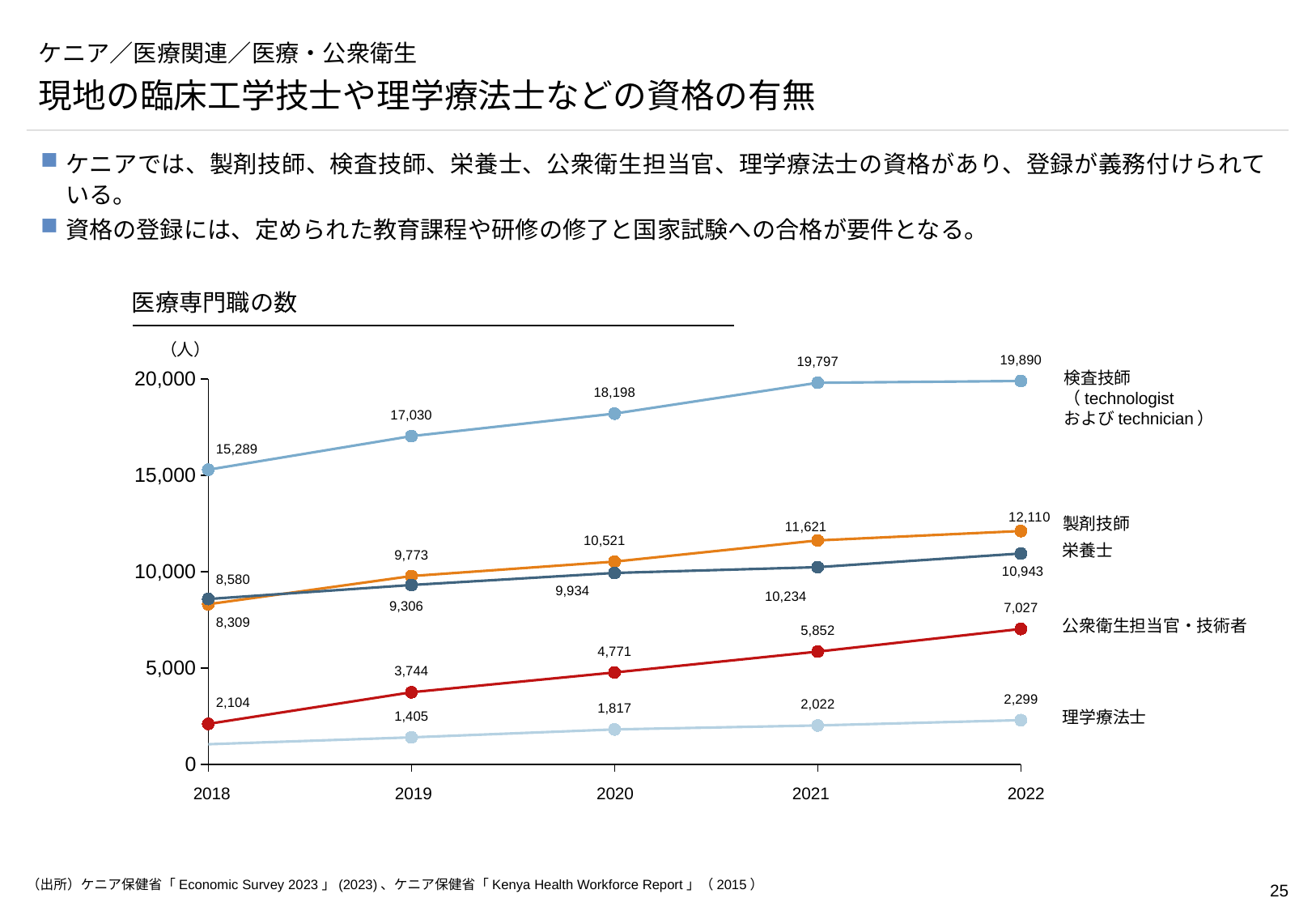
What is the value for 製剤技師 in 2020? 10,521 What is the value for 検査技師 in 2022? 19,890 How many series (professions) are plotted in the chart 医療専門職の数? 5 What is the difference between the 検査技師 values in 2018 and 2022? 4,601 What is the value for 公衆衛生担当官・技術者 in 2019? 3,744 Which profession has the lowest value in 2021? 理学療法士 How many years are shown on the x axis of the chart? 5 What type of chart is shown on the slide? line chart What is the value for 栄養士 in 2021? 10,234 Which is larger in 2018, 製剤技師 or 栄養士? 栄養士 Which profession has the highest value in 2022? 検査技師 Is the value for 理学療法士 in 2018 greater or less than 5,000? less